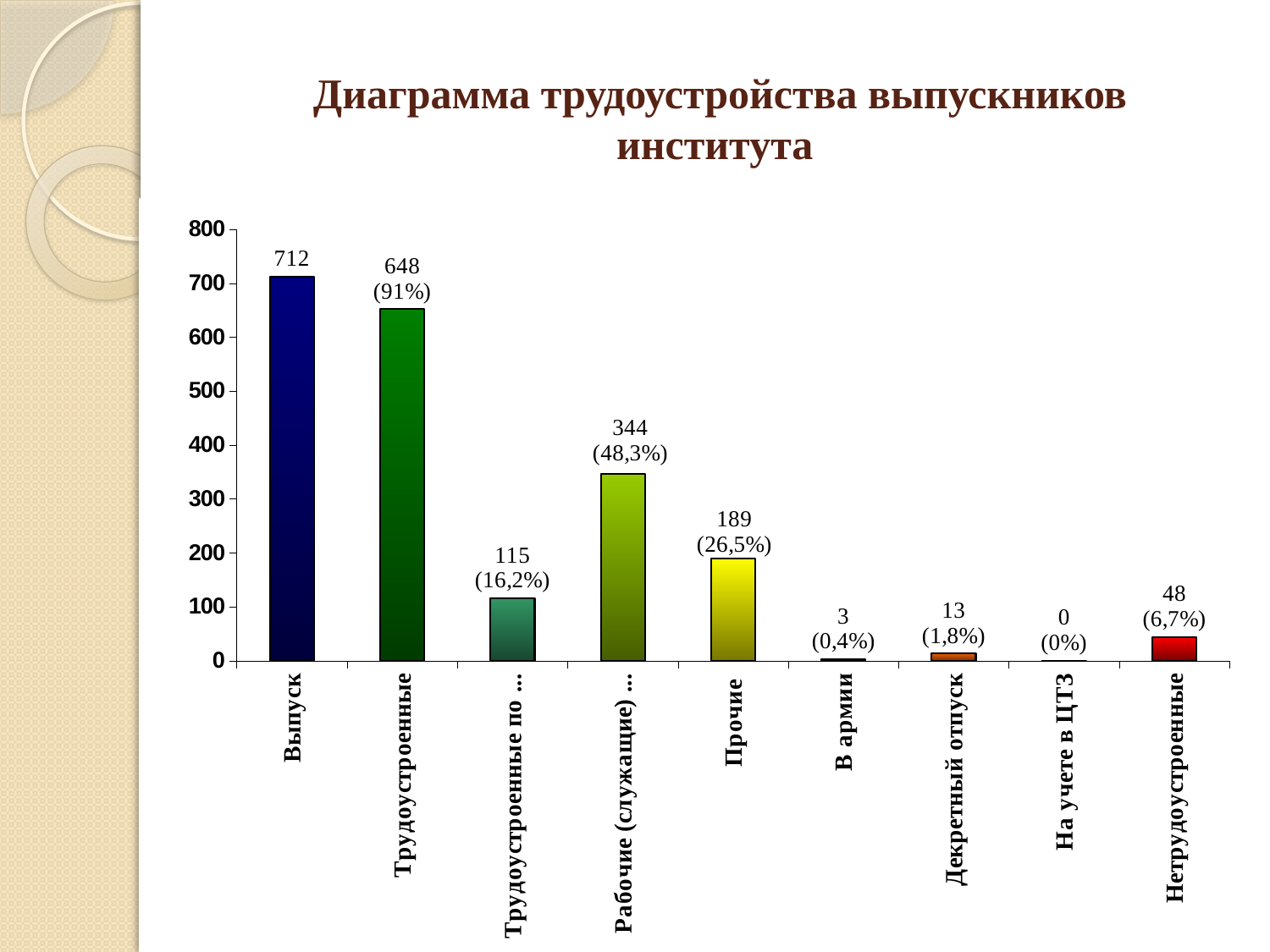
How many categories are shown on the x axis? 9 Which is larger, the value for В армии or the value for Декретный отпуск? Декретный отпуск Which category has the highest value? Выпуск What is the value for Трудоустроенные? 648 What is the value for Нетрудоустроенные? 48 What is the difference between the values for Выпуск and Трудоустроенные? 64 What percentage is shown for Декретный отпуск? 1,8% Which category has the lowest value? На учете в ЦТЗ What percentage is shown for Трудоустроенные? 91% What is the value for Выпуск? 712 What is the value for Прочие? 189 What type of chart is shown on the slide? bar chart